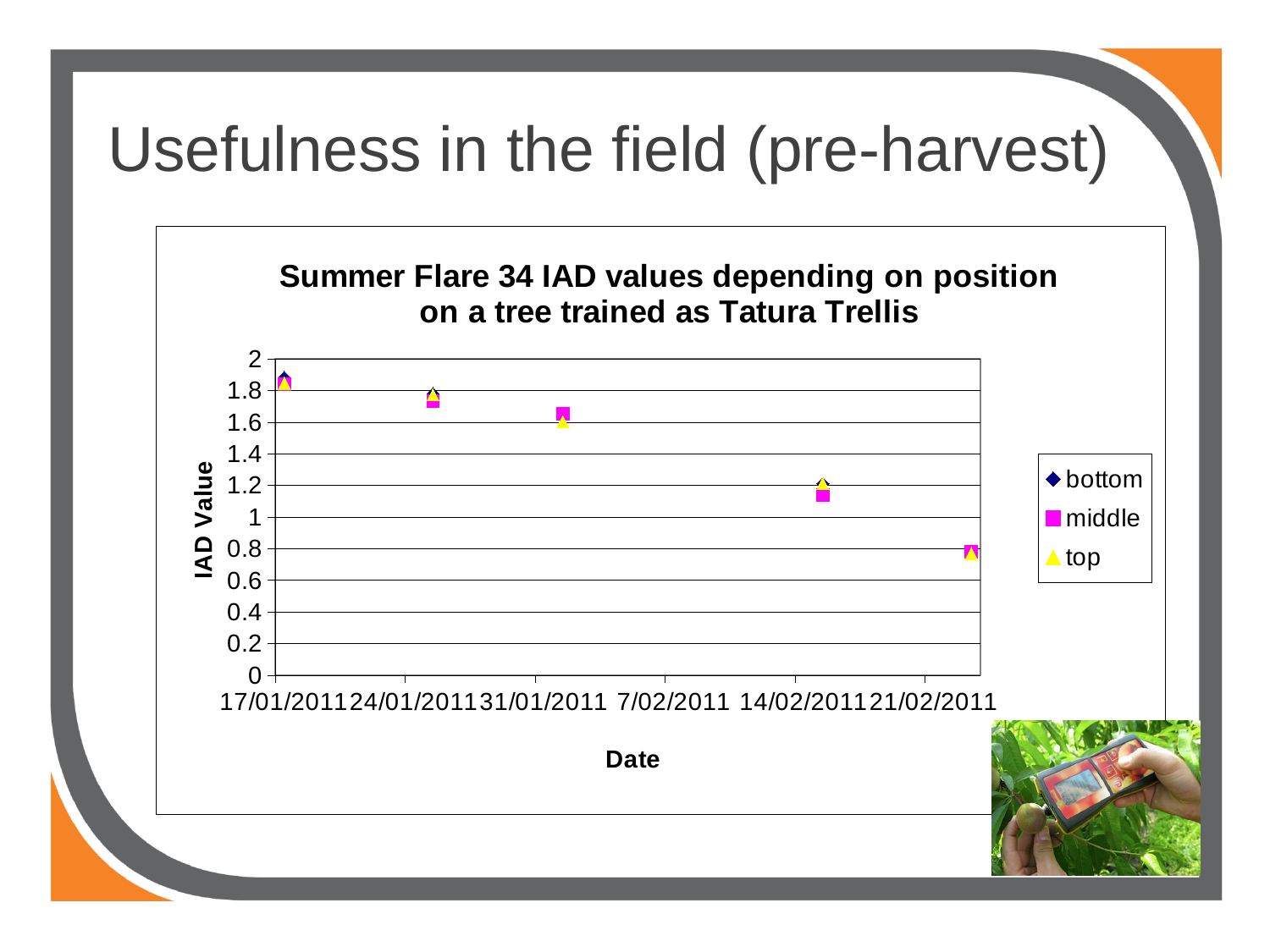
What kind of chart is shown on the slide? scatter chart Which is larger for the middle series: the IAD value at the first date or at the last date? the first date What are the three series named in the legend? bottom, middle, top What is the title of the chart? Summer Flare 34 IAD values depending on position on a tree trained as Tatura Trellis At which date are the IAD values lowest? the last date plotted (after 21/02/2011) Do the IAD values rise or fall over time along the x axis? fall How many data points are plotted for the middle series? 5 Is the IAD value for the bottom series at the fourth date greater or less than 1? greater Is the IAD value for the top series at the third date greater or less than 1.4? greater Is the IAD value for the middle series at the last date greater or less than 1? less How many series does the legend list? 3